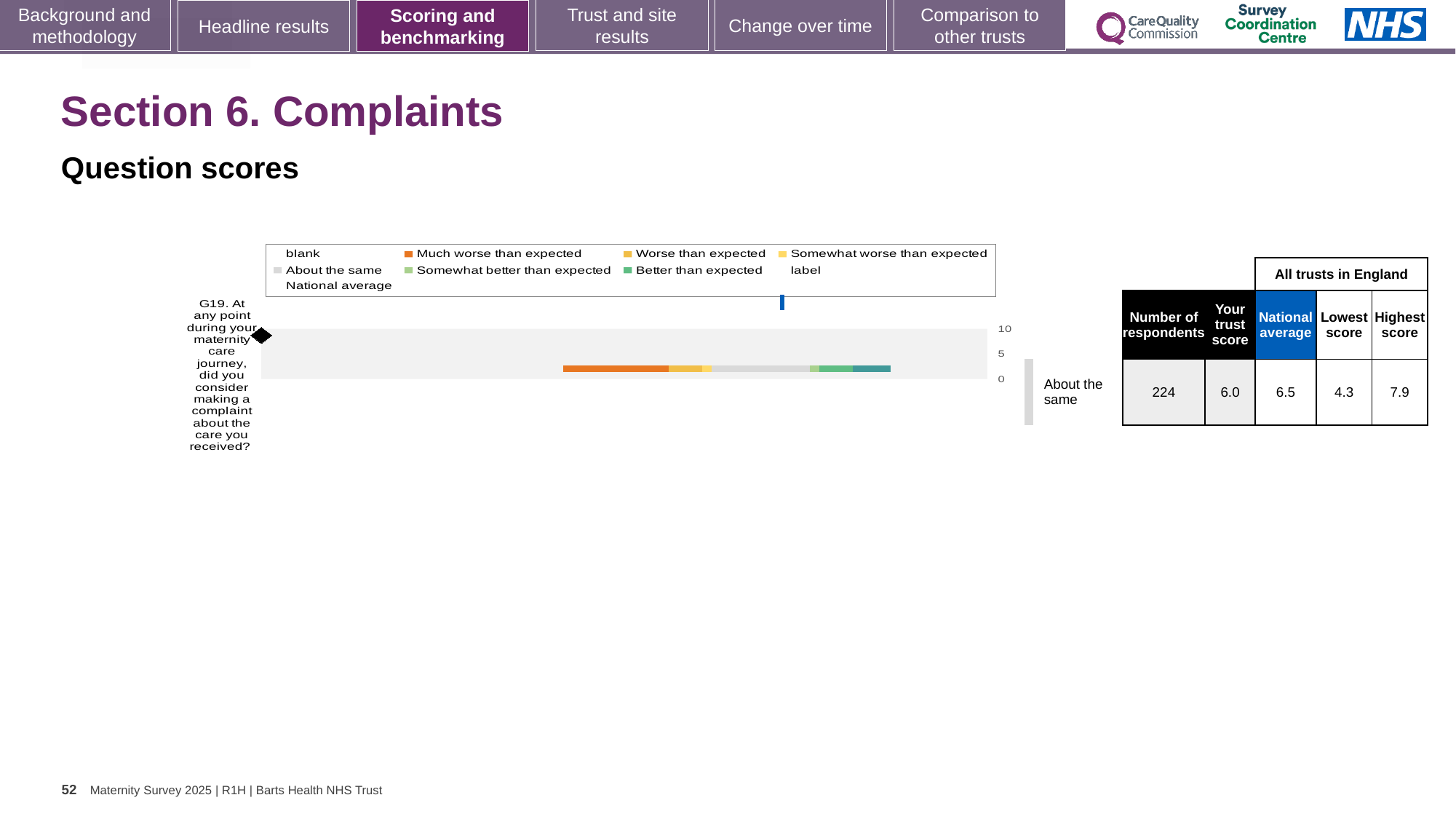
How many respondents answered question G19? 224 What is the highest score among all trusts in England for question G19? 7.9 What is the national average score for question G19? 6.5 What is the trust's score for question G19 shown in the table next to the chart? 6.0 Which benchmark category is the trust's result for G19 placed in? About the same What is the difference between the highest score and the lowest score for question G19? 3.6 How many survey questions are plotted in the chart? 1 Is the national average marker on the chart for G19 greater or less than 5? greater What kind of chart is shown on the slide? bar chart Which is larger for question G19: the trust score or the national average? National average What is the lowest score among all trusts in England for question G19? 4.3 What colour does the legend use for 'Much worse than expected'? Orange